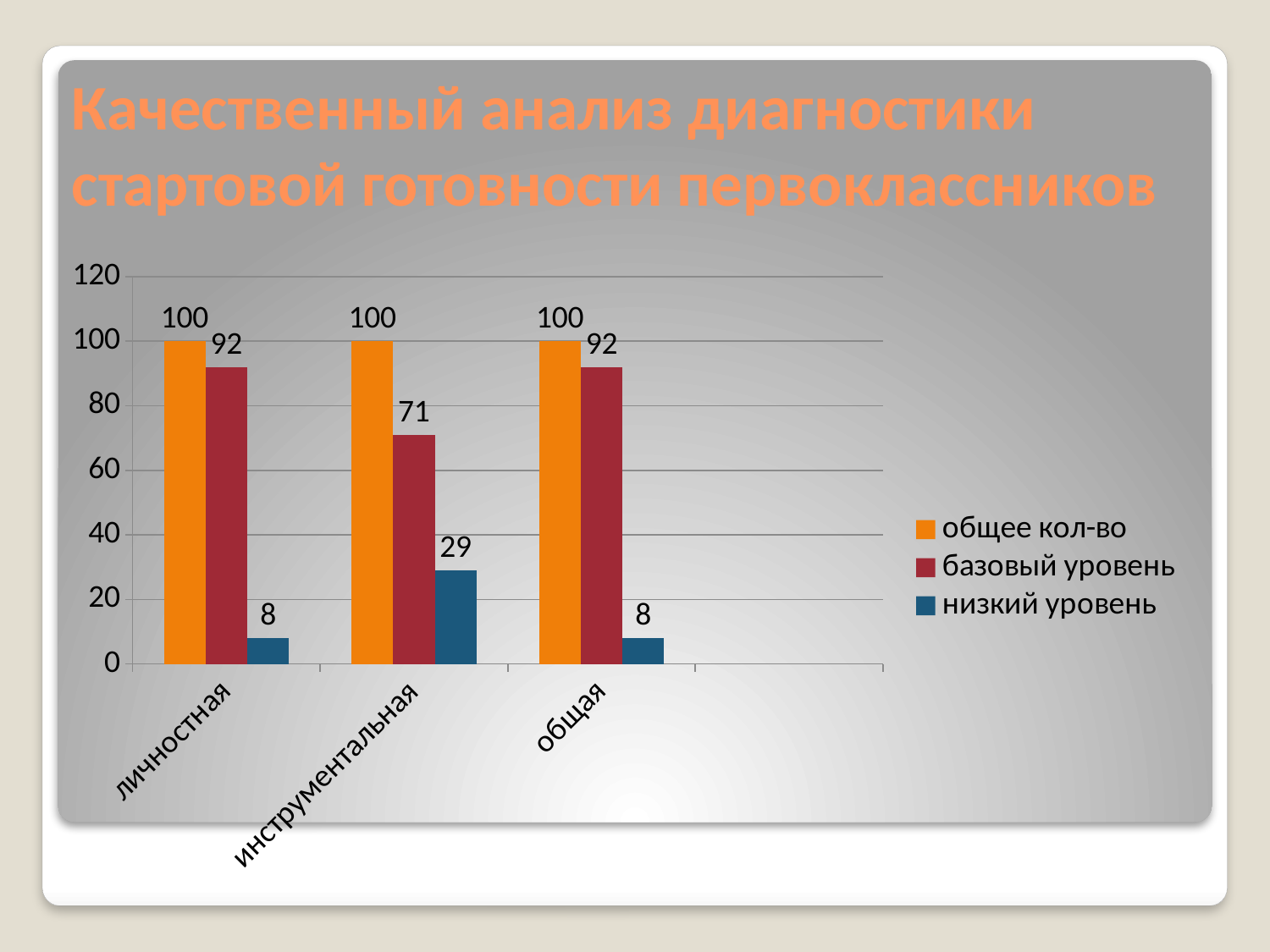
What is the value of 'базовый уровень' for 'личностная'? 92 What is the value of 'низкий уровень' for 'инструментальная'? 29 What is the value of 'низкий уровень' for 'общая'? 8 Which category has the highest value for 'низкий уровень'? инструментальная What is the difference between 'базовый уровень' and 'низкий уровень' for 'инструментальная'? 42 How many series does the legend list? 3 What kind of chart is shown on the slide? bar chart Which is larger: 'базовый уровень' for 'личностная' or 'базовый уровень' for 'инструментальная'? личностная What is the value of 'базовый уровень' for 'инструментальная'? 71 Which series is shown in blue in the legend? низкий уровень Which category has the lowest value for 'базовый уровень'? инструментальная How many categories are shown on the x axis? 3